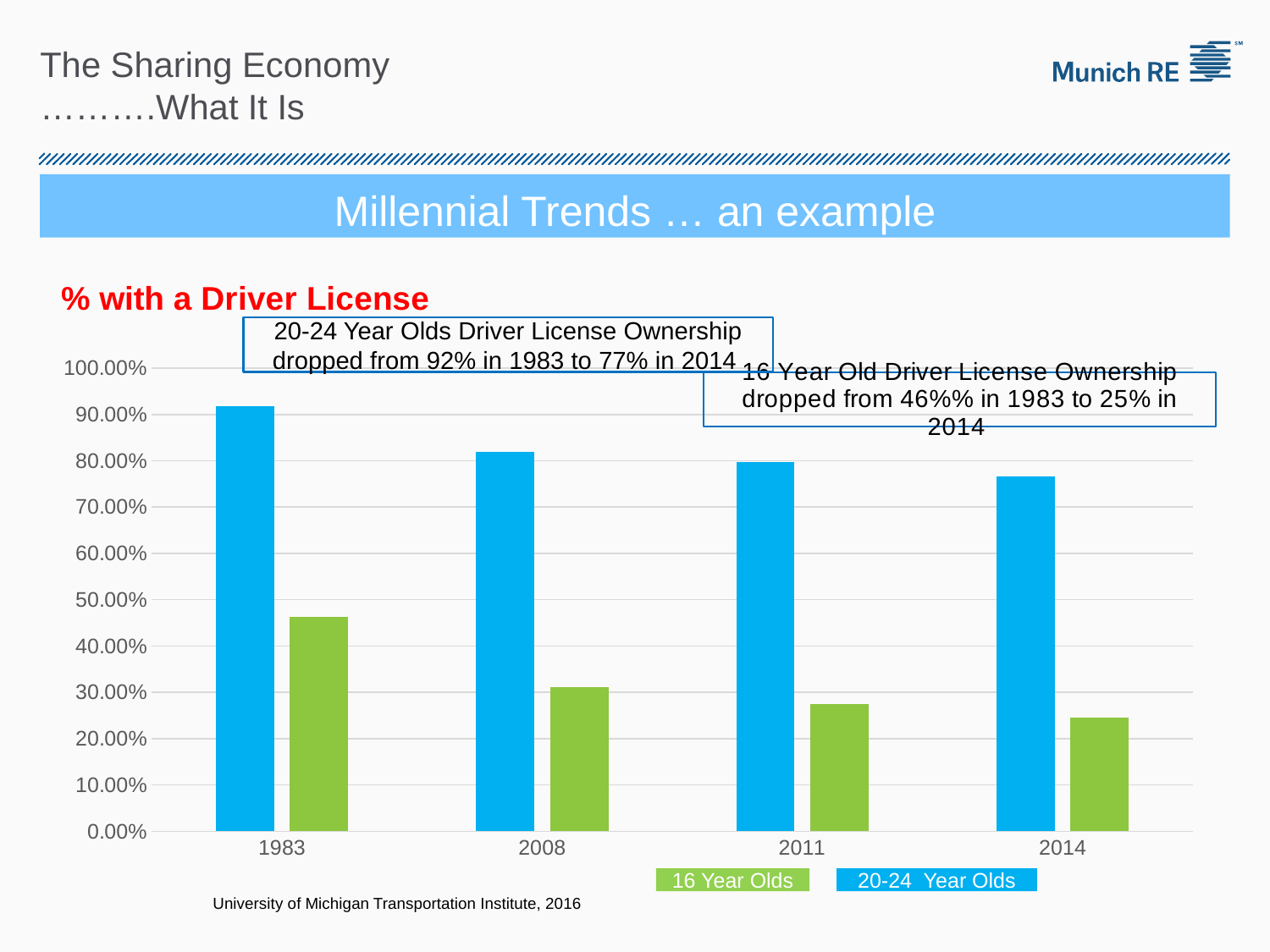
Do the values for 16 Year Olds rise or fall from 1983 to 2014? fall By how many percentage points did 16 year olds' driver license ownership drop from 1983 to 2014? 21 What kind of chart is shown on the slide? bar chart How many years are shown on the x axis of the chart? 4 Which year has the highest value for 20-24 Year Olds? 1983 By how many percentage points did 20-24 year olds' driver license ownership drop from 1983 to 2014? 15 How many series does the legend list? 2 Is the value for 16 Year Olds in 2011 greater or less than 30.00%? less According to the slide, what was the driver license ownership for 16 year olds in 2014? 25% According to the slide, what was the driver license ownership for 20-24 year olds in 2014? 77% According to the slide, what was the driver license ownership for 20-24 year olds in 1983? 92% Which year has the lowest value for 16 Year Olds? 2014